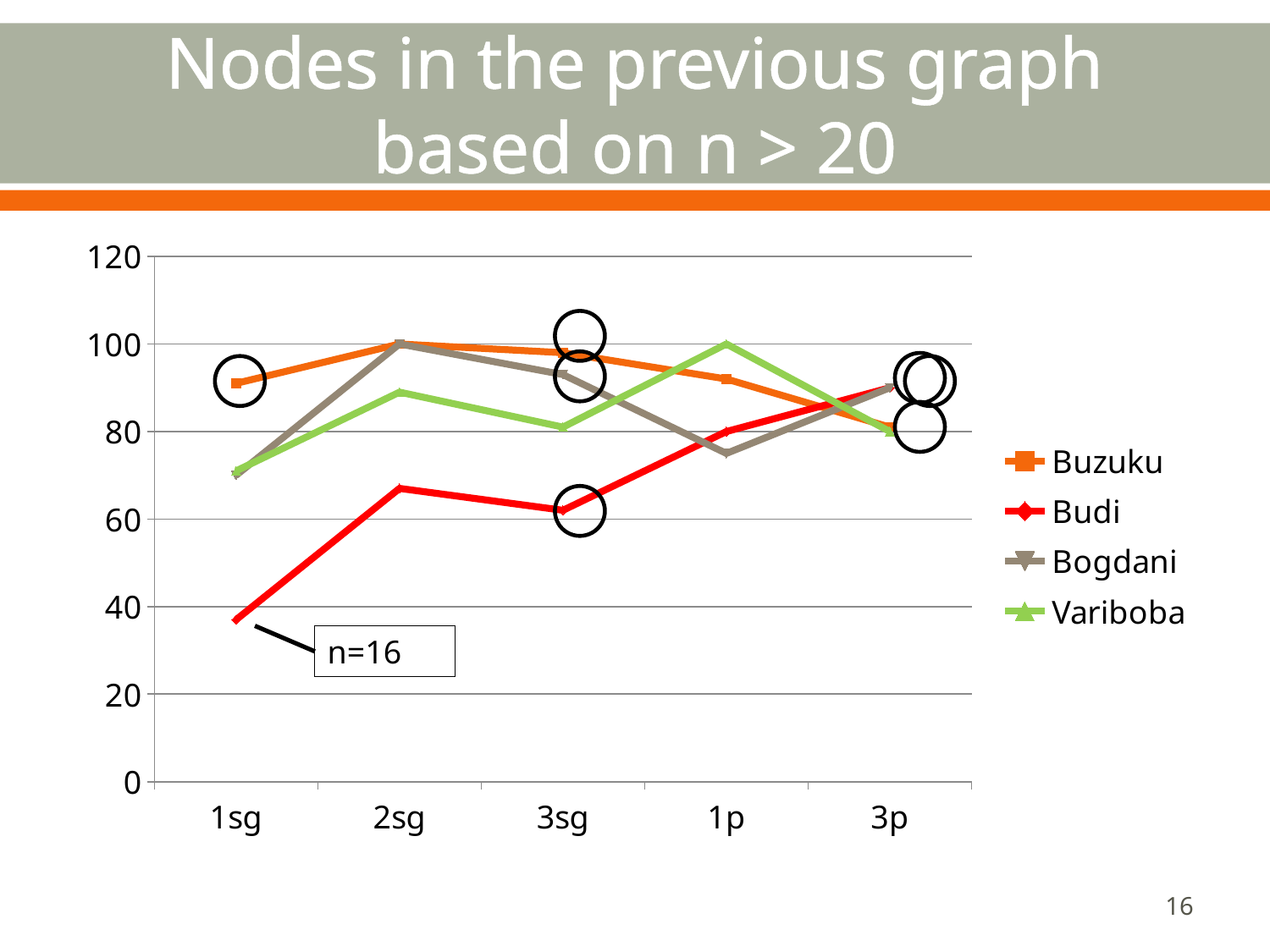
What kind of chart is shown on the slide? line chart Is the value for Budi at 1sg greater or less than 40? less How many categories are on the x axis? 5 Is the value for Budi at 2sg greater or less than 60? greater Does the Budi line rise or fall from 1sg to 2sg? rise Which series has the lowest value at 1sg? Budi What text is in the annotation box pointing to the Budi point at 1sg? n=16 Which series has the highest value at 1p? Variboba What is the value for Variboba at 1p? 100 Is the value for Bogdani at 1p greater or less than 80? less At 3sg, which is larger, the value for Buzuku or the value for Budi? Buzuku How many series does the legend list? 4